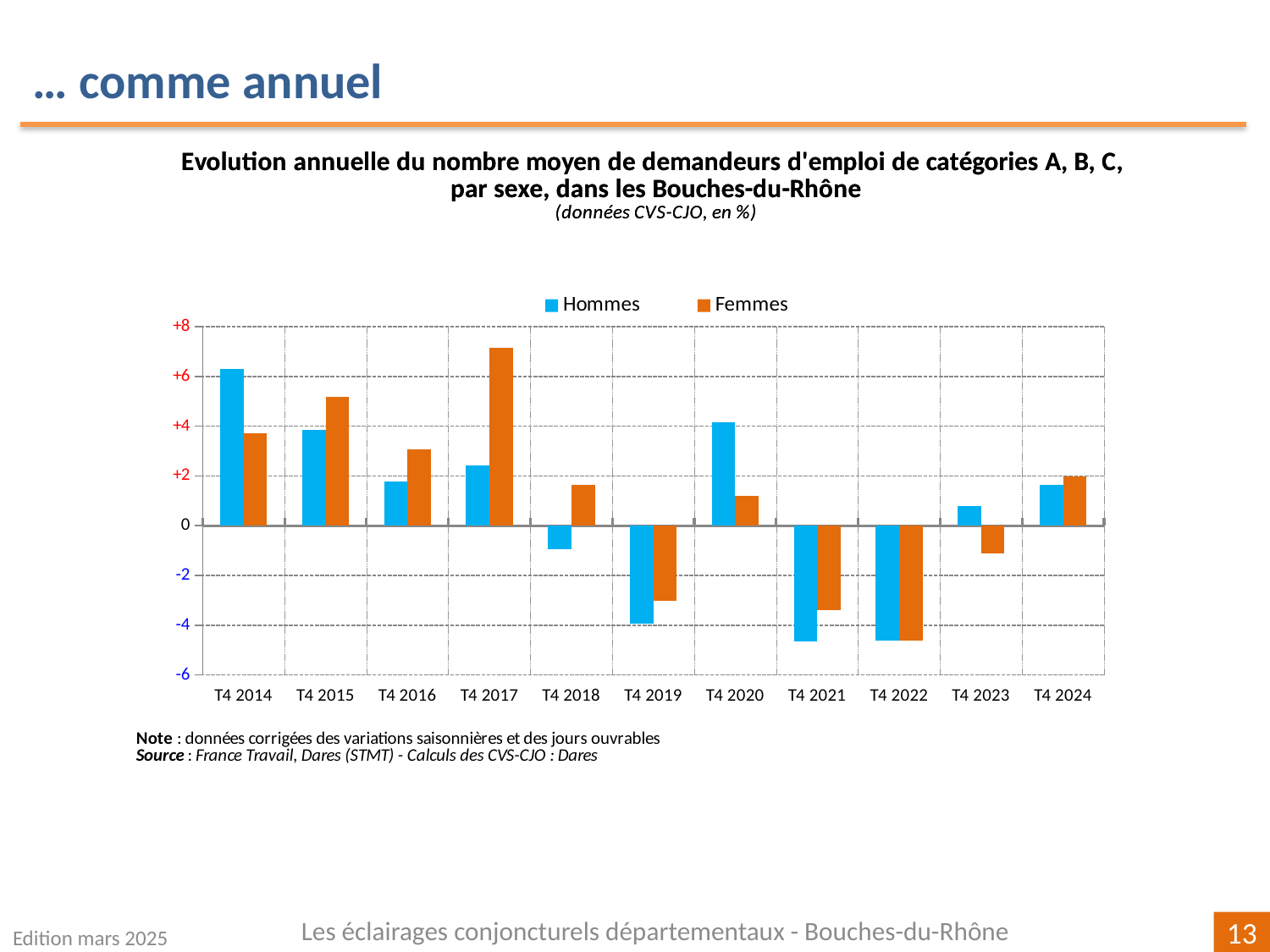
Which colour represents the Femmes series in the chart? Orange Is the Femmes value for T4 2016 greater or less than +2? greater How many series does the legend list? 2 How many time periods (categories) are shown on the x axis? 11 For T4 2017, which series has the larger value, Hommes or Femmes? Femmes Is the Femmes value for T4 2017 greater or less than +6? greater In which period is the Hommes value the highest? T4 2014 Is the Hommes value for T4 2019 greater or less than -2? less For T4 2020, which series has the larger value, Hommes or Femmes? Hommes In which period is the Femmes value the lowest? T4 2022 In which period is the Femmes value the highest? T4 2017 What kind of chart is shown on the slide? Bar chart